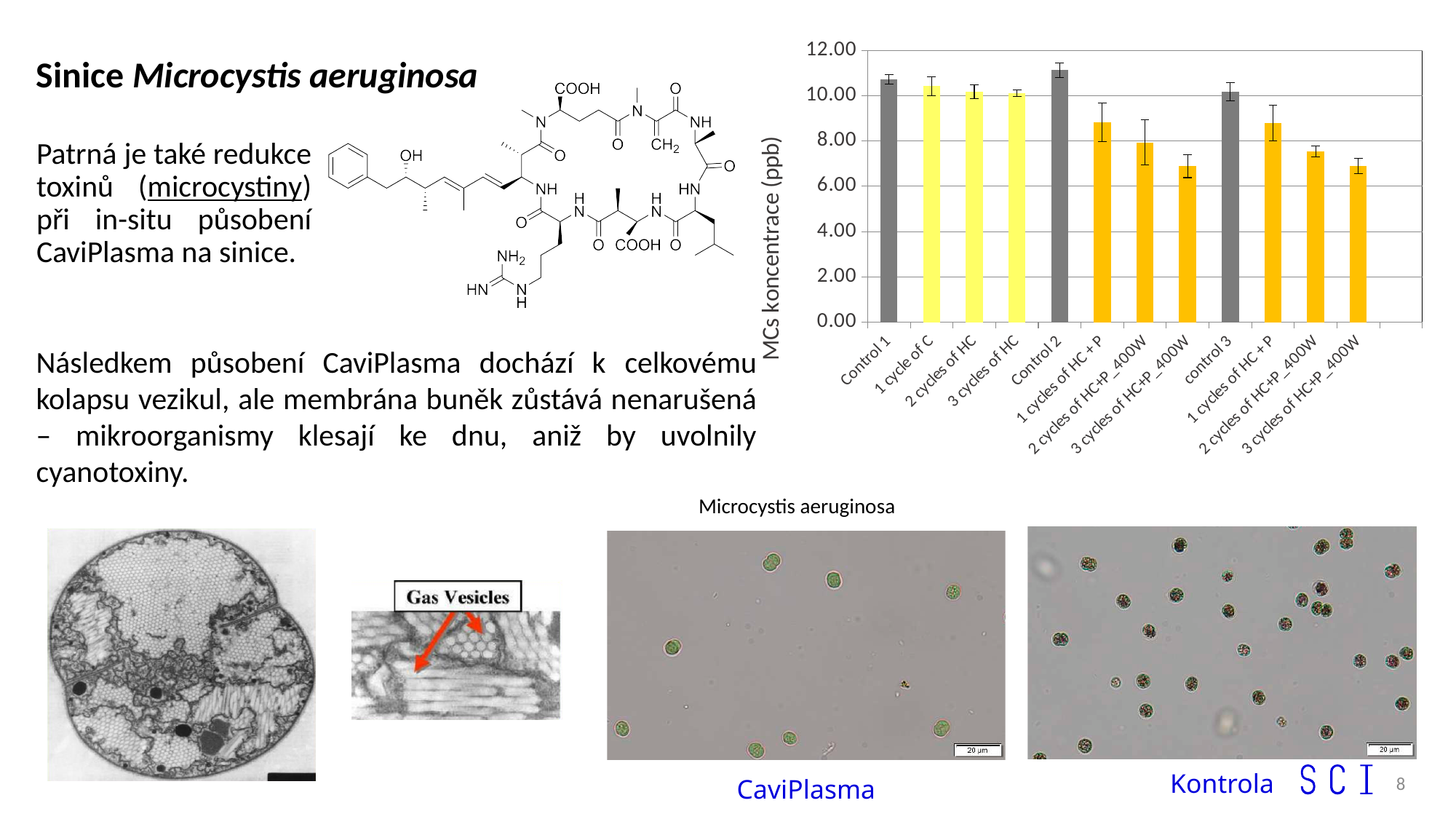
Which category has the highest value in the bar chart? Control 2 Is the value for Control 1 greater or less than 10.00? greater Is the value for Control 2 greater or less than 10.00? greater What kind of chart is shown on the slide? bar chart Which is larger, the value for Control 1 or the value for 3 cycles of HC+P _400W? Control 1 How many categories are shown on the x axis of the bar chart? 12 Is the value for 3 cycles of HC+P _400W greater or less than 8.00? less What is the label of the y axis of the bar chart? MCs koncentrace (ppb) Do the values rise or fall from 1 cycles of HC + P to 3 cycles of HC+P _400W in the bar chart? fall Which is larger, the value for Control 2 or the value for 1 cycles of HC + P? Control 2